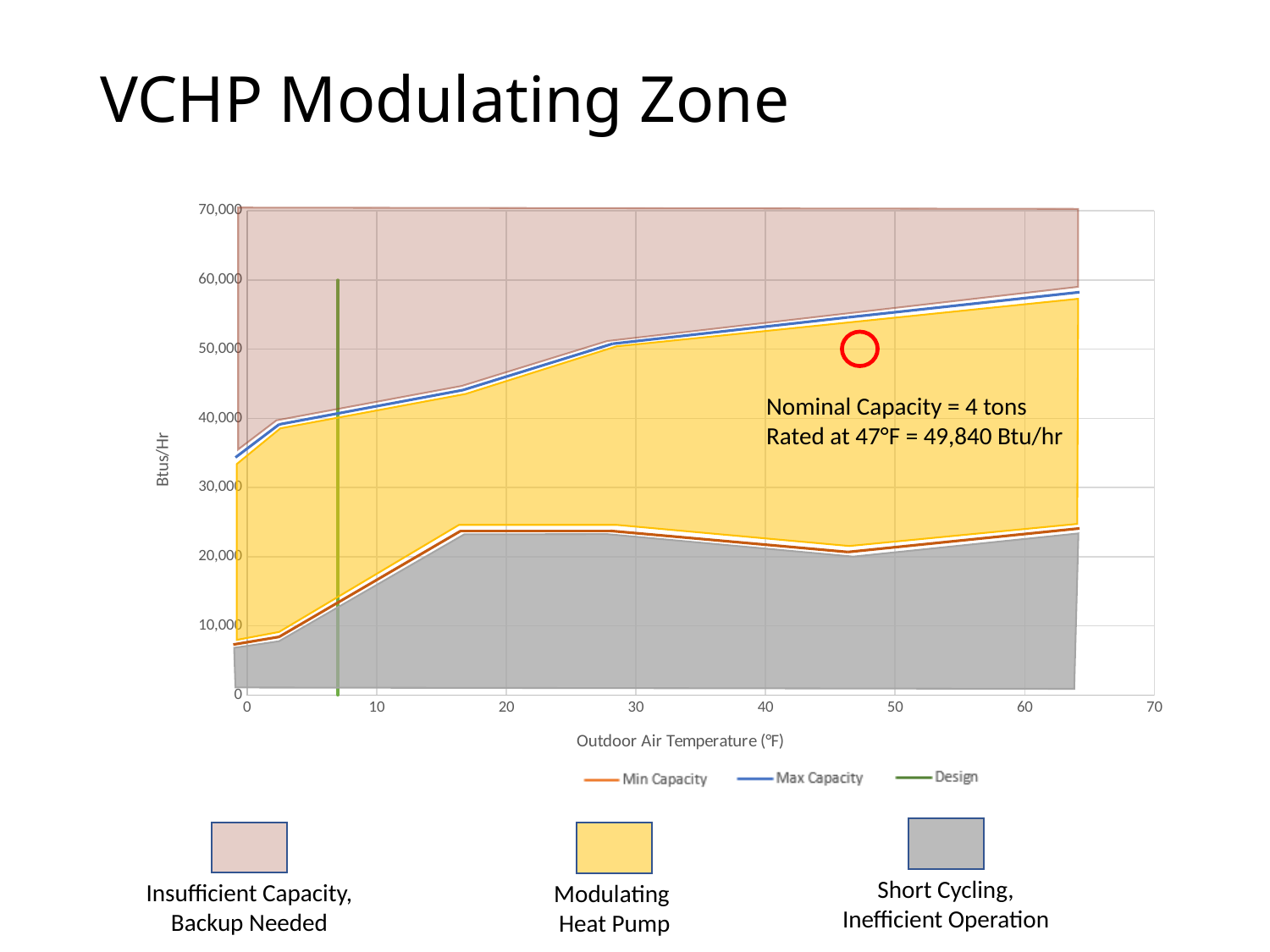
Is the Max Capacity value at 0°F greater or less than 30,000? greater What kind of chart is shown on the slide? line chart Is the Max Capacity value at 60°F greater or less than 50,000? greater According to the annotation on the chart, what is the rated capacity at 47°F? 49,840 Btu/hr How many series does the chart legend list? 3 At 40°F, which is larger: Max Capacity or Min Capacity? Max Capacity Is the outdoor air temperature at which the Design line is drawn greater or less than 10? less What is the title of the chart's y axis? Btus/Hr Does the Max Capacity line rise or fall as outdoor air temperature increases? rise What is the title of the chart's x axis? Outdoor Air Temperature (°F)